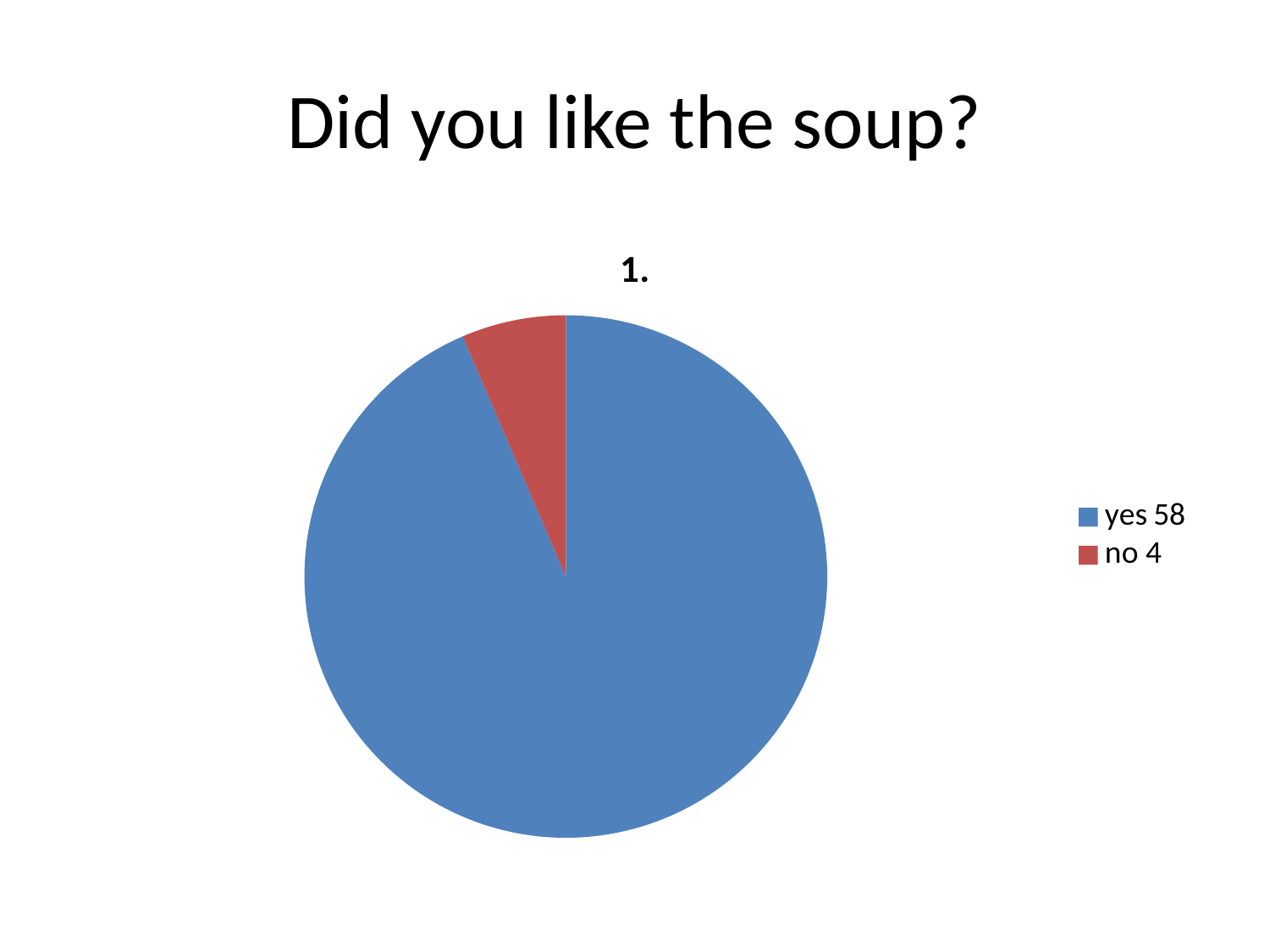
What colour is the slice for yes? blue What is the title of the slide? Did you like the soup? Which response has the largest slice of the pie? yes How many people answered yes according to the legend? 58 How many slices does the pie chart have? 2 How many people answered no according to the legend? 4 Which is larger, the number of yes responses or the number of no responses? yes What is the difference between the number of yes responses and the number of no responses? 54 Which response has the smallest slice of the pie? no How many entries does the legend list? 2 What kind of chart is shown on the slide? pie chart